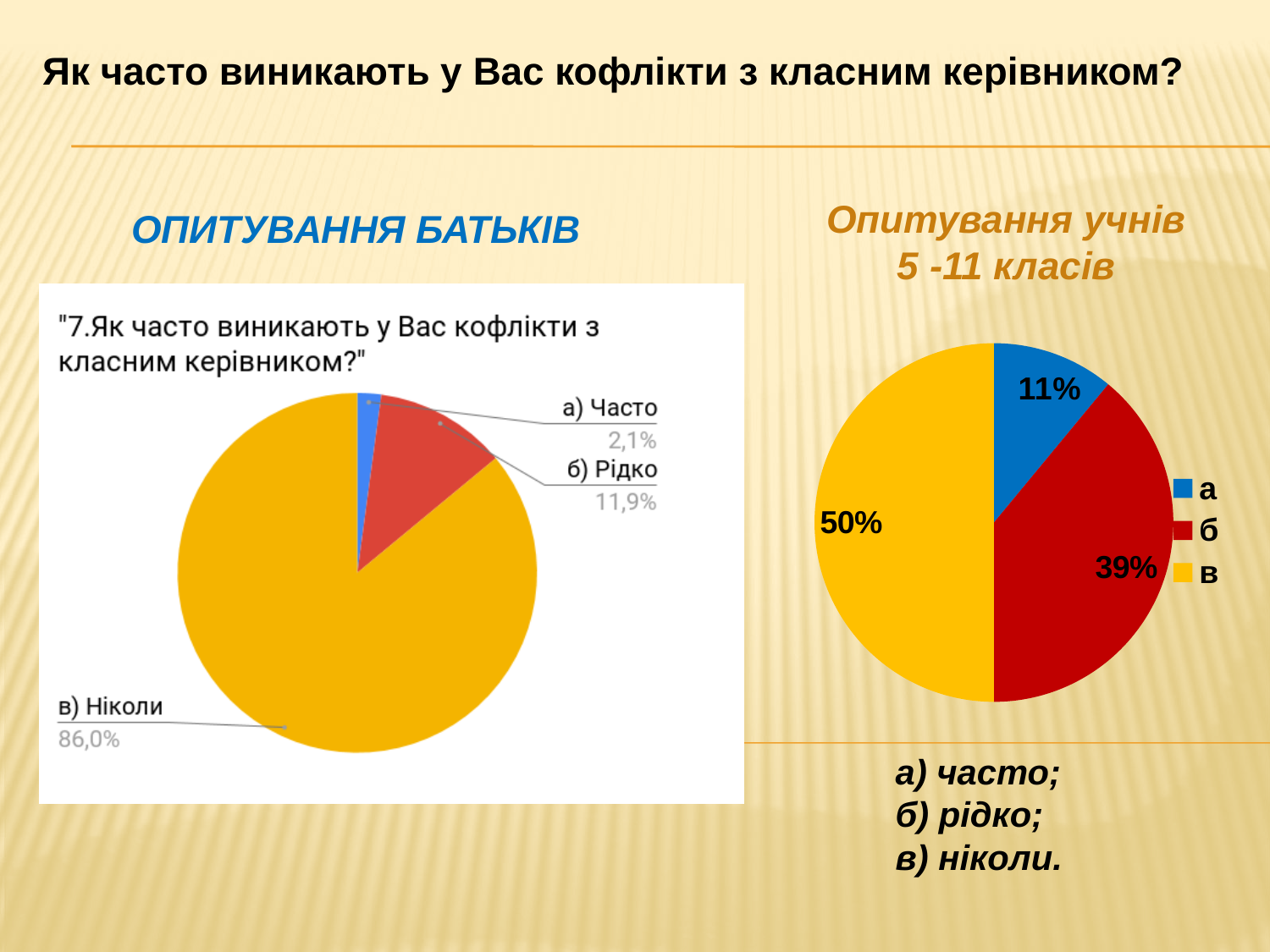
In the left chart (parents' survey), which option has the smallest share? а) Часто How many entries does the legend of the right chart (students of grades 5-11) list? 3 In the right chart (students of grades 5-11), what percentage is shown for option "б"? 39% In the left chart (parents' survey), which is larger: the share for "б) Рідко" or "а) Часто"? б) Рідко In the right chart (students of grades 5-11), which option has the largest share? в In the left chart (parents' survey), what percentage chose "а) Часто"? 2,1% In the right chart (students of grades 5-11), what percentage is shown for option "а"? 11% What type of chart is used on the left side of the slide (parents' survey)? Pie chart In the left chart (parents' survey), what percentage chose "в) Ніколи"? 86,0% How many slices does the right chart (students of grades 5-11) have? 3 In the right chart (students of grades 5-11), what is the difference between the shares for "в" and "б"? 11% In the left chart (parents' survey), what percentage chose "б) Рідко"? 11,9%